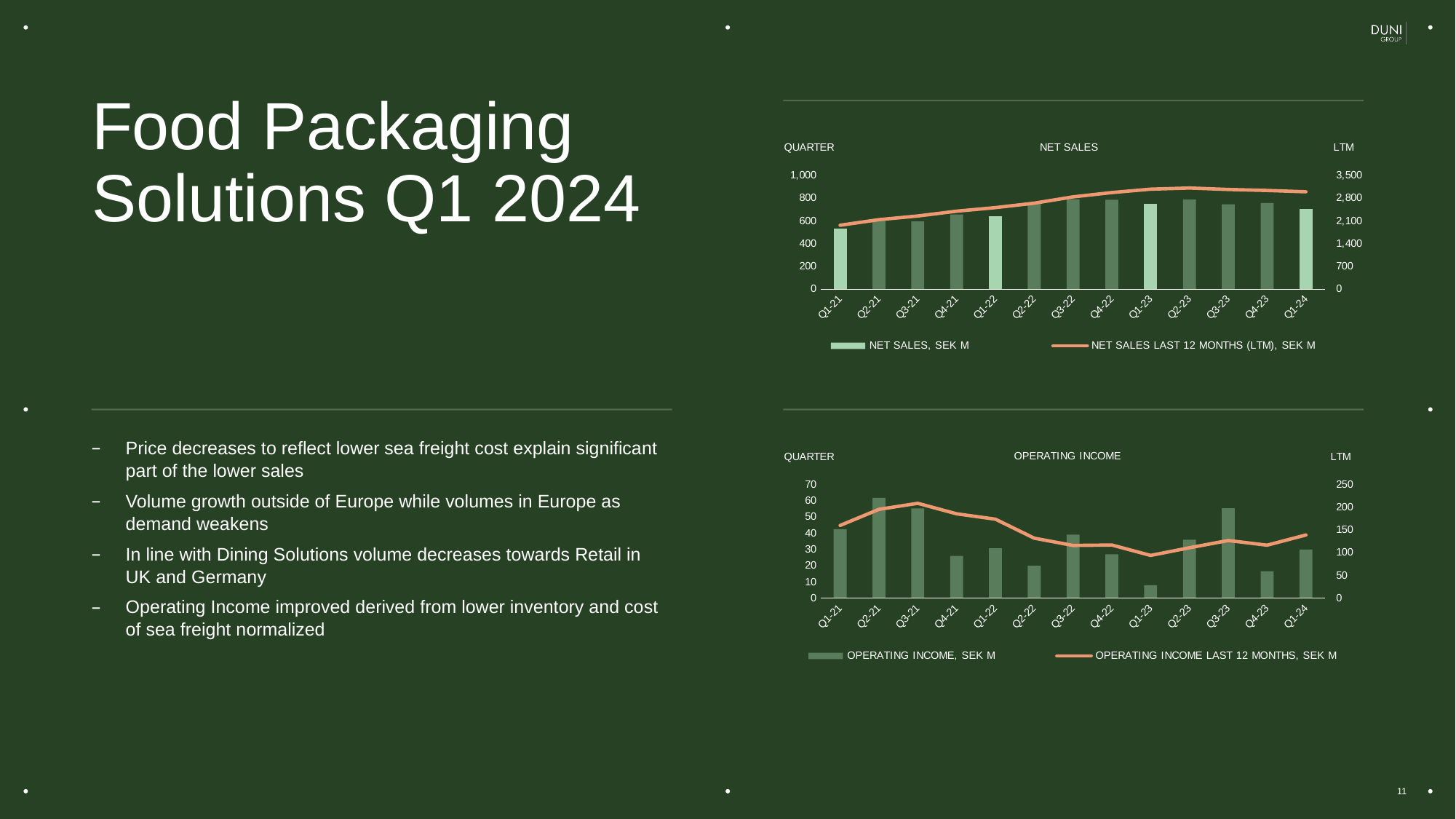
How many series does the legend of the OPERATING INCOME chart list? 2 In the NET SALES chart, which quarter has the lowest quarterly net sales bar? Q1-21 In the OPERATING INCOME chart, which is larger, the operating income bar for Q2-21 or for Q4-21? Q2-21 How many quarters are shown on the x axis of the NET SALES chart? 13 What is the label of the right-hand axis on the NET SALES chart? LTM In the OPERATING INCOME chart, is the operating income for Q2-21 greater or less than 50? greater In the NET SALES chart, does the NET SALES LAST 12 MONTHS (LTM) line rise or fall from Q1-21 to Q2-23? rise In the OPERATING INCOME chart, which quarter has the lowest operating income bar? Q1-23 What kind of chart is the NET SALES chart? Bar chart with a line In the NET SALES chart, is the quarterly net sales value for Q1-21 greater or less than 600? less In the NET SALES chart, is the quarterly net sales value for Q3-22 greater or less than 600? greater